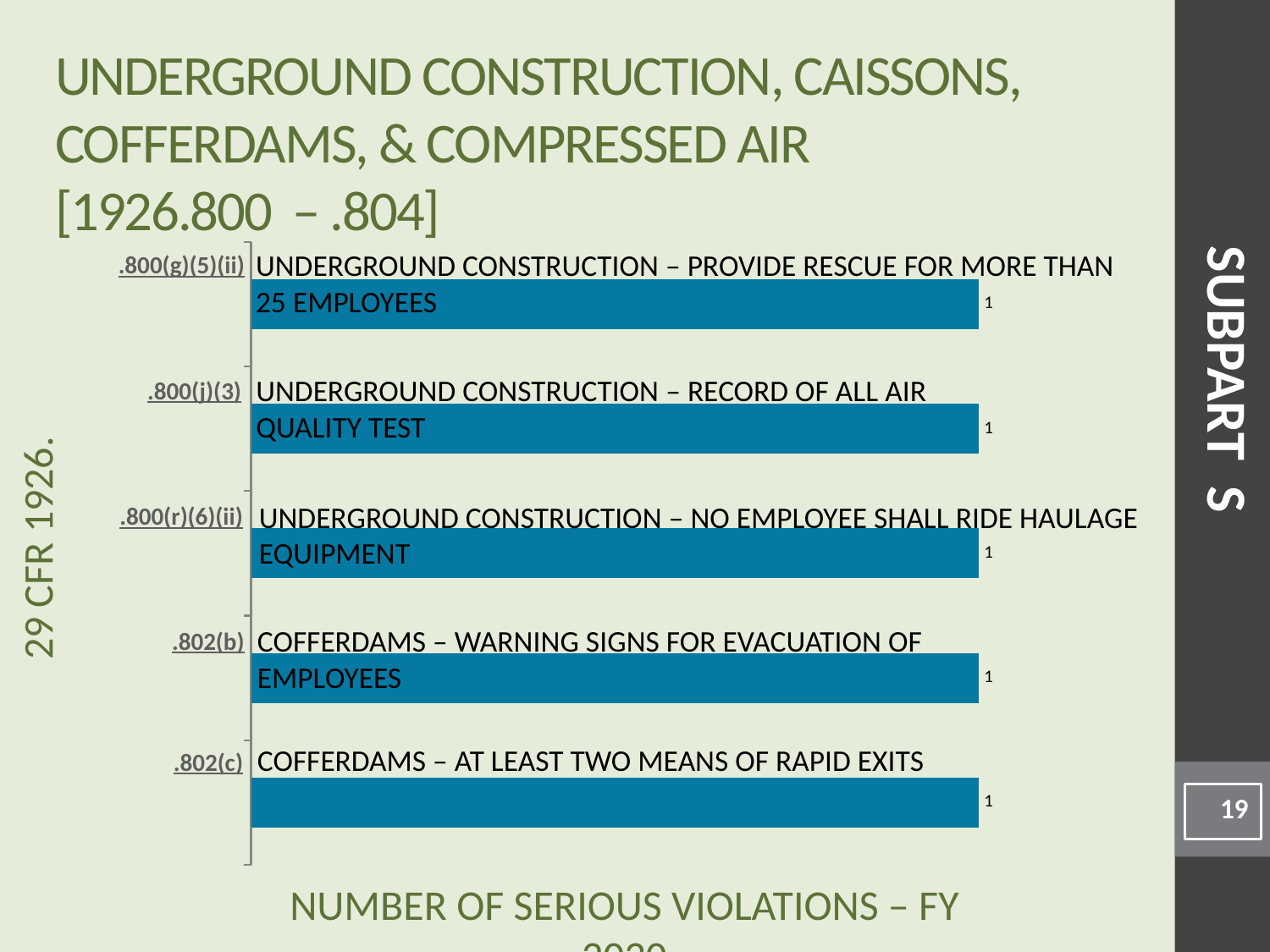
What kind of chart is shown on the slide? Bar chart How many categories (standards) are plotted in the chart? 5 What is the number of serious violations for .800(r)(6)(ii)? 1 Do the values for the five standards differ from one another, or are they all the same? All the same What is the number of serious violations for .800(j)(3)? 1 What is the difference between the values for .802(b) and .802(c)? 0 What is the number of serious violations for .800(g)(5)(ii)? 1 What is the number of serious violations for .802(b)? 1 Which standard is described as 'COFFERDAMS – AT LEAST TWO MEANS OF RAPID EXITS'? .802(c) What is the number of serious violations for .802(c)? 1